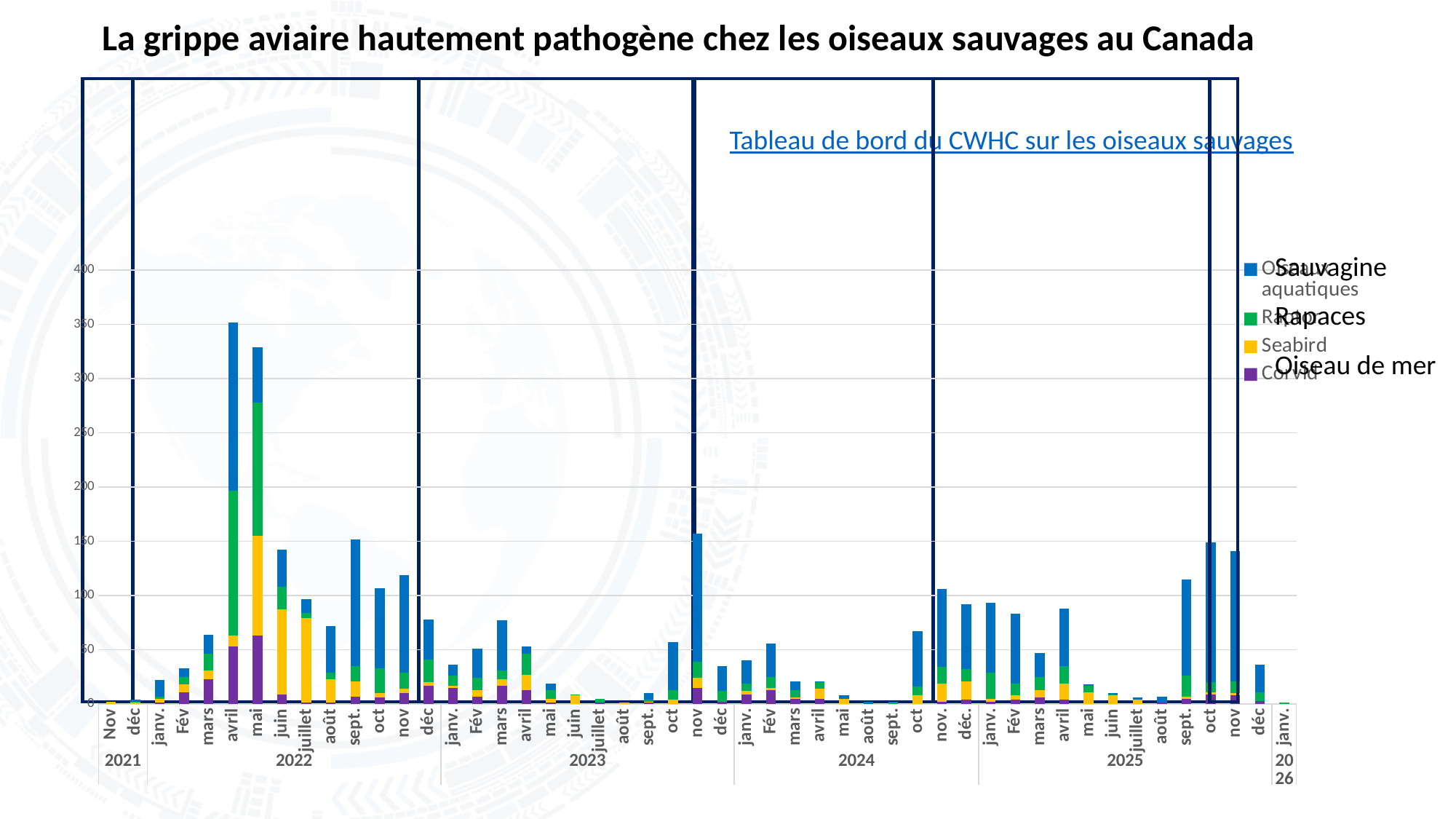
Which bar is taller, nov 2023 or déc 2023? nov 2023 What is the title of the slide? La grippe aviaire hautement pathogène chez les oiseaux sauvages au Canada Is the total value for avril 2022 greater or less than 300? greater Is the total value for oct 2025 greater or less than 100? greater Is the total value for mai 2022 greater or less than 300? greater How many series does the chart's legend list? 4 What kind of chart is shown on the slide? Stacked bar chart Which month has the tallest bar in the chart? avril 2022 How many year labels appear along the x axis of the chart? 6 Which bar is taller, avril 2022 or nov 2023? avril 2022